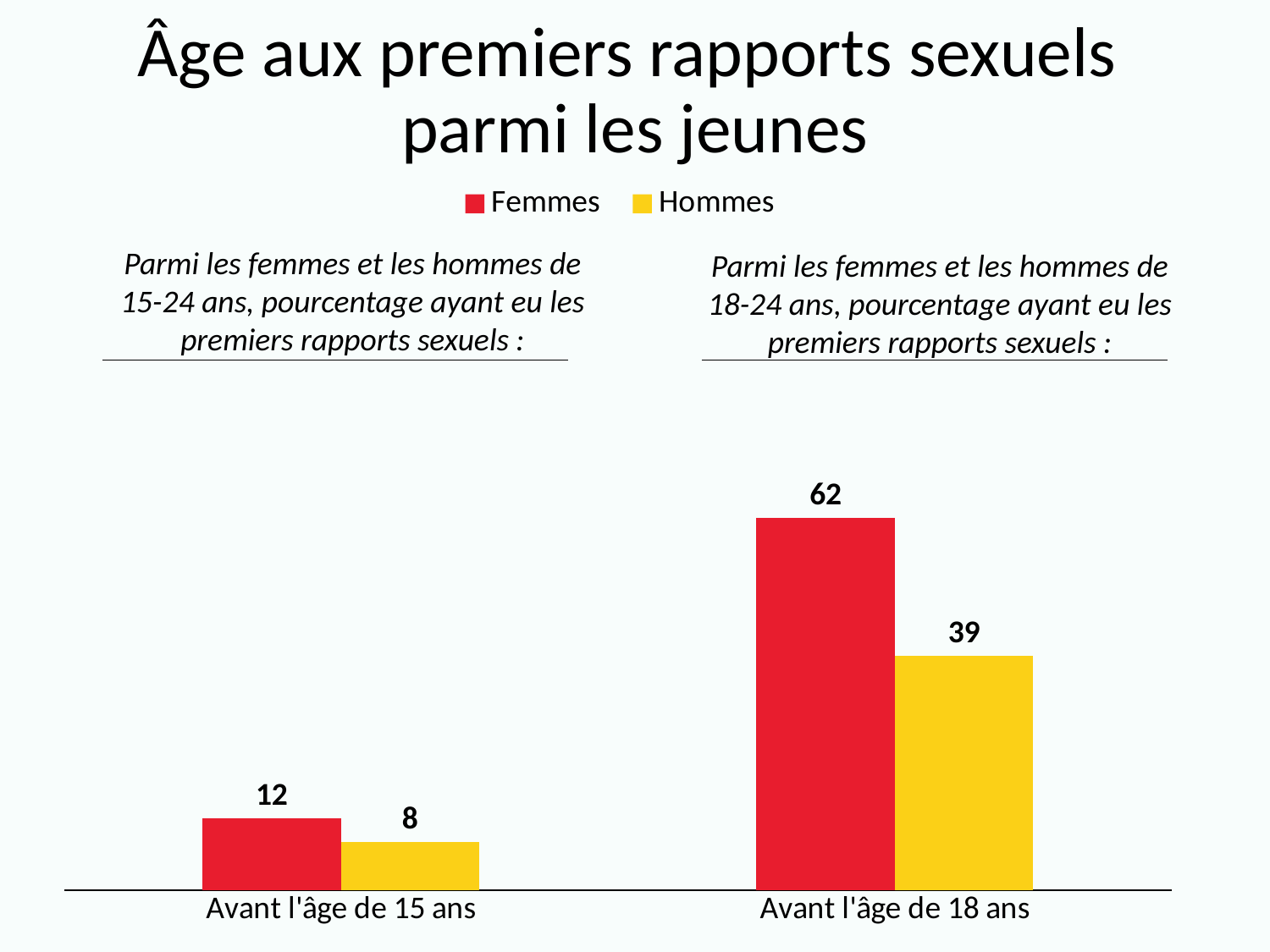
What is the value for Femmes in the 'Avant l'âge de 18 ans' category? 62 How many series does the legend list? 2 What is the value for Hommes in the 'Avant l'âge de 18 ans' category? 39 What is the difference between the Femmes and Hommes values for 'Avant l'âge de 18 ans'? 23 Which is larger: the Femmes value for 'Avant l'âge de 15 ans' or the Hommes value for 'Avant l'âge de 18 ans'? Hommes, Avant l'âge de 18 ans What kind of chart is shown on the slide? Bar chart What is the difference between the Femmes and Hommes values for 'Avant l'âge de 15 ans'? 4 Which bar has the highest value on the chart? Femmes, Avant l'âge de 18 ans What is the value for Hommes in the 'Avant l'âge de 15 ans' category? 8 What is the value for Femmes in the 'Avant l'âge de 15 ans' category? 12 How many categories are shown on the x axis? 2 Which bar has the lowest value on the chart? Hommes, Avant l'âge de 15 ans